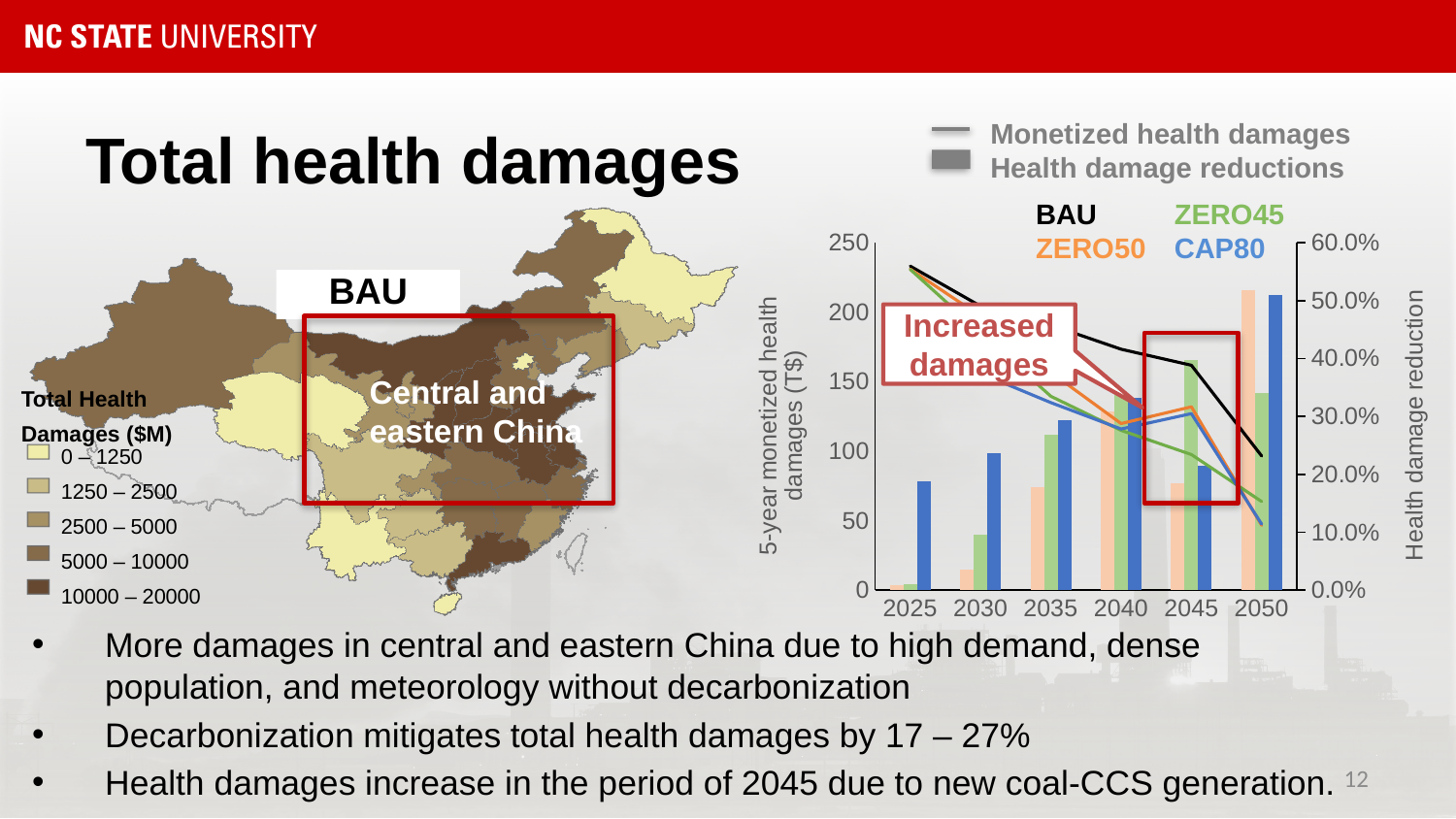
Is the ZERO50 health damage reduction in 2030 greater or less than 10.0%? less Is the CAP80 health damage reduction in 2050 greater or less than 40.0%? greater In 2045, which line shows higher monetized health damages, BAU or ZERO45? BAU Does the BAU monetized health damages line rise or fall from 2025 to 2050? Fall Is the BAU monetized health damages value in 2025 greater or less than 200 T$? greater How many scenarios does the chart legend list? 4 How many years are shown on the x axis of the chart? 6 Which scenario has the lowest health damage reduction bar in 2030? ZERO50 What kind of chart is shown on the right of the slide? A combined line and bar chart Which scenario has the highest health damage reduction bar in 2030? CAP80 Which scenario has the highest health damage reduction bar in 2045? ZERO45